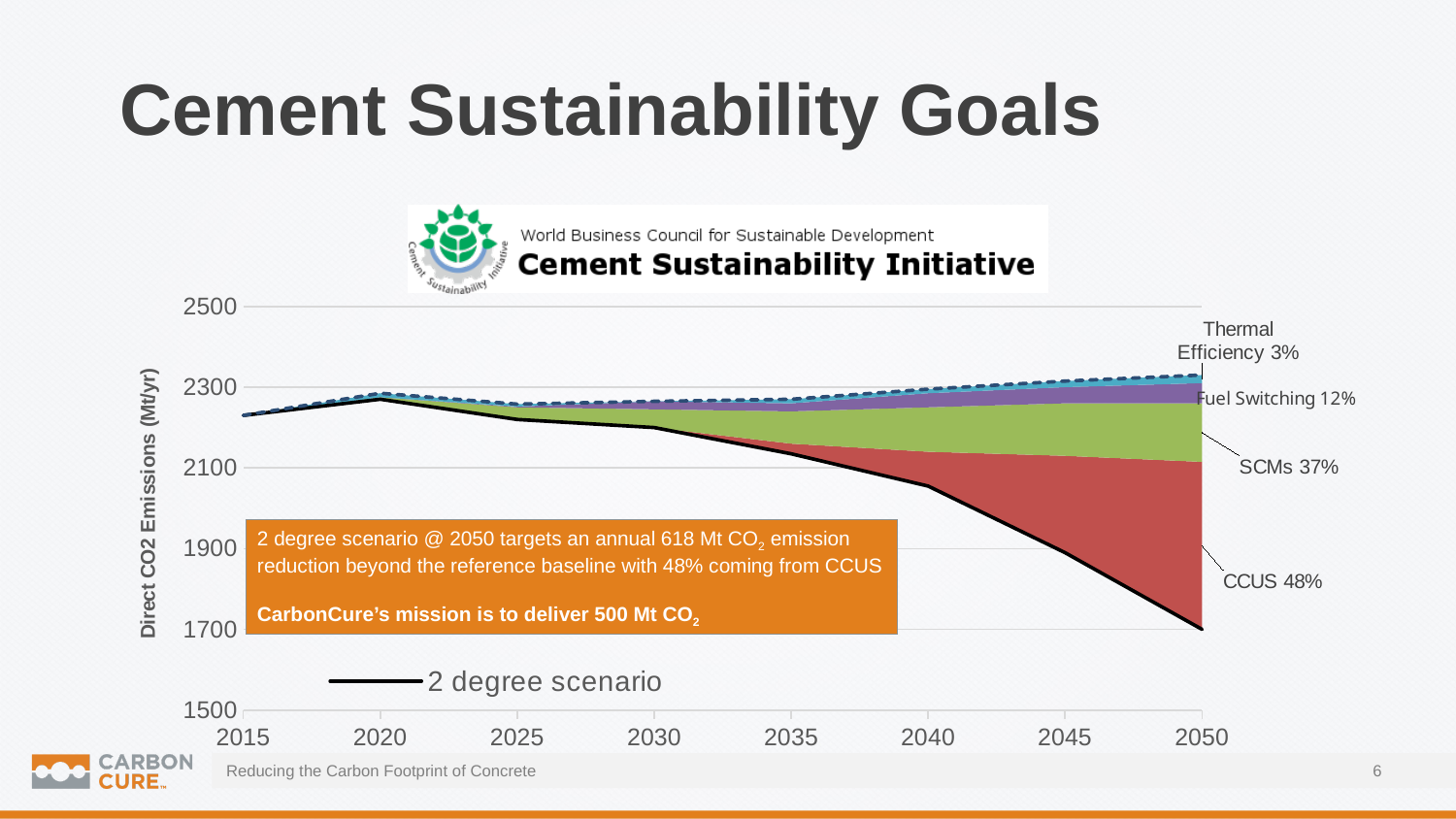
Which labelled reduction lever has the smallest percentage share? Thermal Efficiency What percentage of the emission reduction is attributed to SCMs? 37% What percentage of the emission reduction is attributed to Fuel Switching? 12% What is the label on the vertical axis of the chart? Direct CO2 Emissions (Mt/yr) How many percentage points larger is the CCUS share than the SCMs share? 11 Which labelled reduction lever has the largest percentage share? CCUS Which is larger, the Fuel Switching share or the SCMs share? SCMs Is the 2 degree scenario value in 2050 greater or less than 1900? less What percentage of the emission reduction is attributed to CCUS in the chart? 48% Does the 2 degree scenario line rise or fall between 2020 and 2050? fall What percentage of the emission reduction is attributed to Thermal Efficiency? 3% Is the 2 degree scenario value in 2015 greater or less than 2100? greater